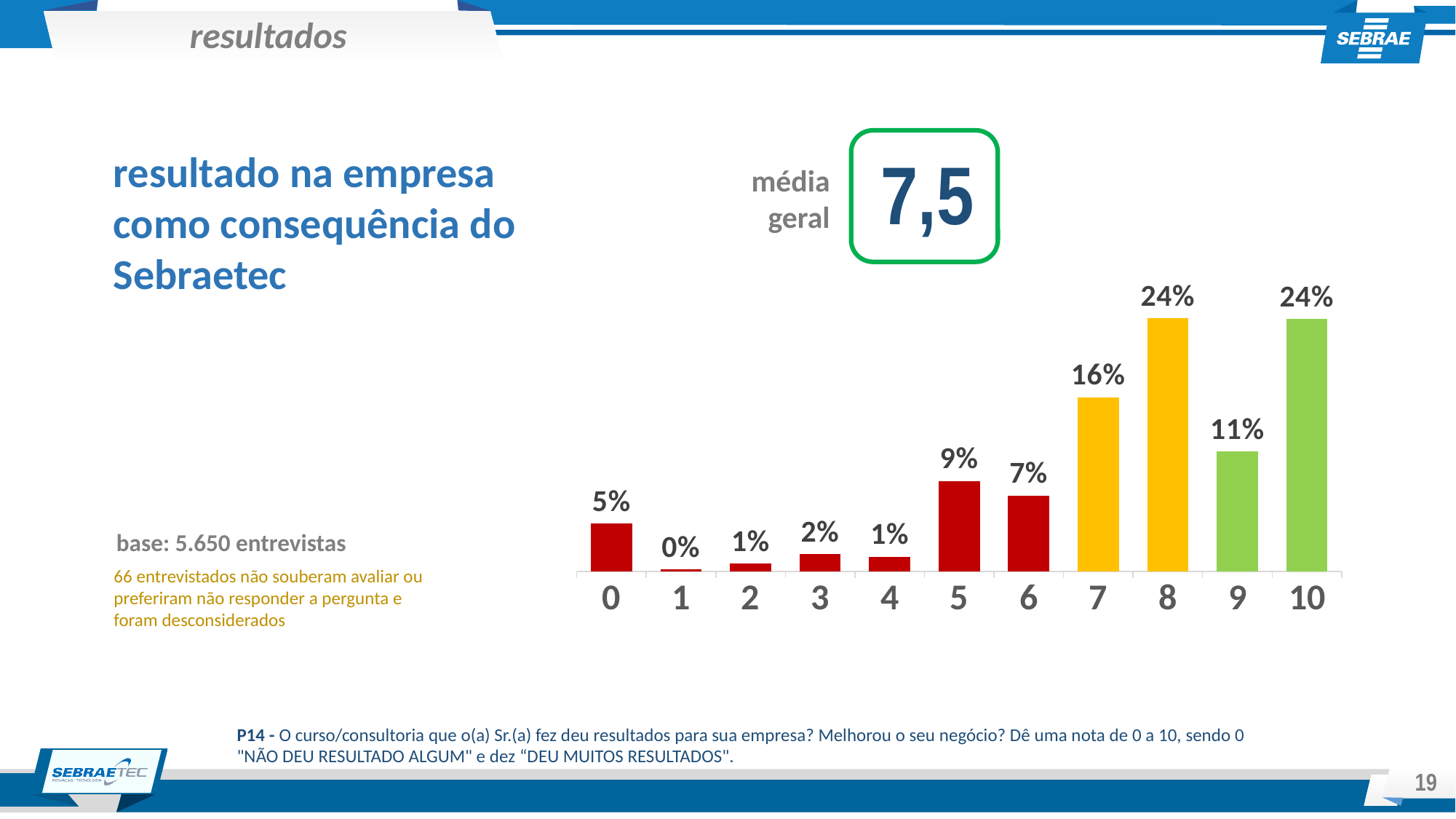
What kind of chart is used to show the distribution of scores? Bar chart What is the combined percentage for scores 9 and 10? 35% Which score has the lowest percentage of respondents? 1 What percentage of respondents gave a score of 7? 16% What is the highest percentage shown for any score in the chart? 24% What percentage of respondents gave a score of 9? 11% Which score has a larger percentage, 5 or 6? 5 How many score categories are shown on the x axis of the chart? 11 What percentage of respondents gave a score of 0? 5% What is the 'média geral' (overall average) shown next to the chart? 7,5 What percentage of respondents gave a score of 8? 24% What is the difference in percentage points between the score of 8 and the score of 9? 13